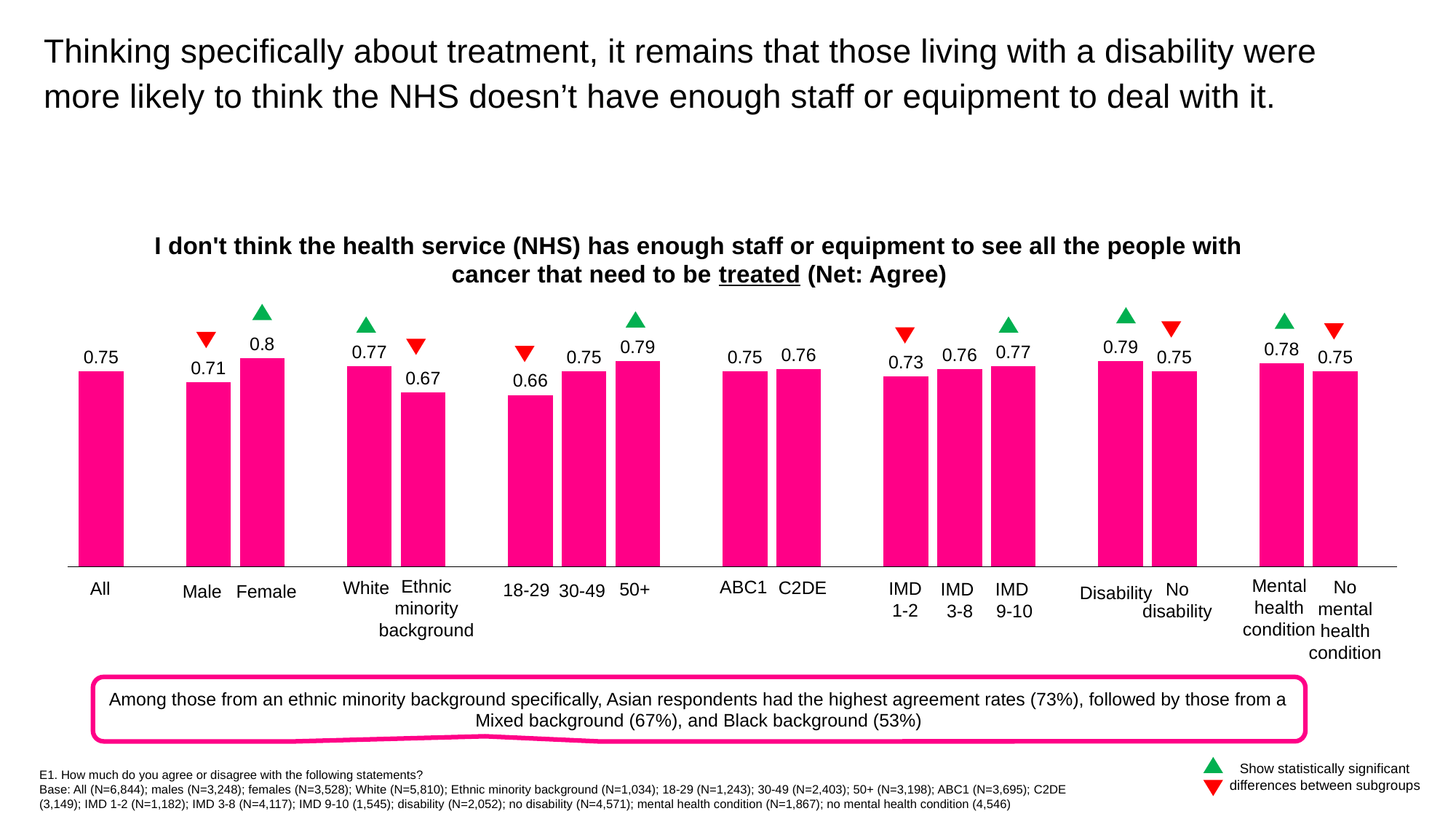
What type of chart is shown on the slide? Bar chart What is the difference between the values for Female and Male? 0.09 Do the values rise or fall across the age groups from 18-29 to 50+? Rise Which is larger, the value for White or the value for Ethnic minority background? White What is the difference between the values for Disability and No disability? 0.04 Which category has the highest value? Female What is the value for Disability? 0.79 What is the value for the 18-29 age group? 0.66 What is the value for Ethnic minority background? 0.67 What is the value for Female? 0.8 Which category has the lowest value? 18-29 How many bars are plotted in the chart? 17